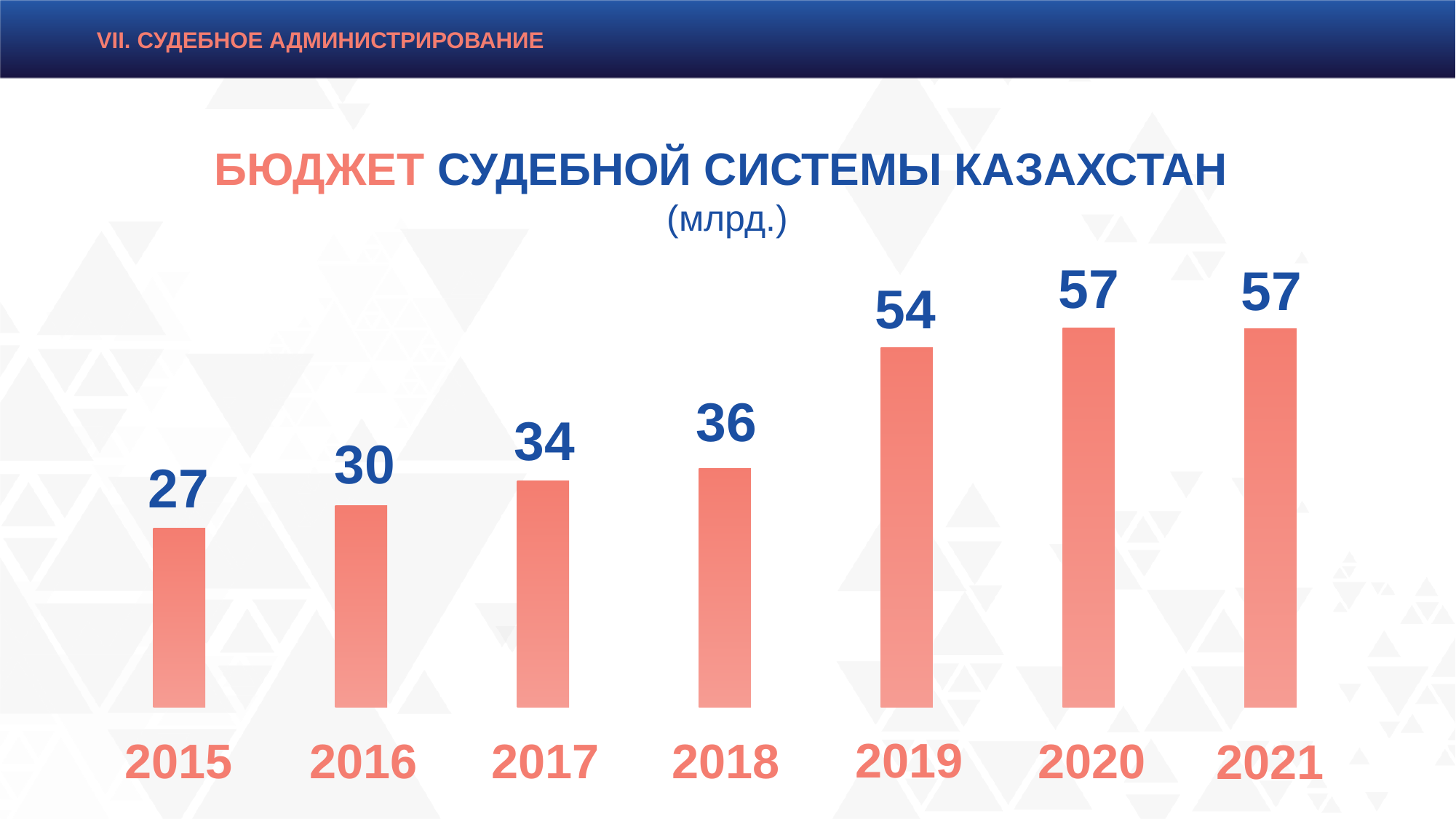
What is the budget value shown for 2015? 27 What is the difference between the values for 2019 and 2018? 18 Which year has the lowest budget value? 2015 What is the budget value shown for 2019? 54 Do the values generally rise or fall from 2015 to 2021? Rise What is the budget value shown for 2018? 36 What is the highest value shown on the chart? 57 Which is larger, the value for 2017 or the value for 2016? 2017 What unit is given in parentheses under the chart title? млрд. What kind of chart is shown on the slide? Bar chart What is the difference between the values for 2021 and 2015? 30 How many years are shown on the chart? 7